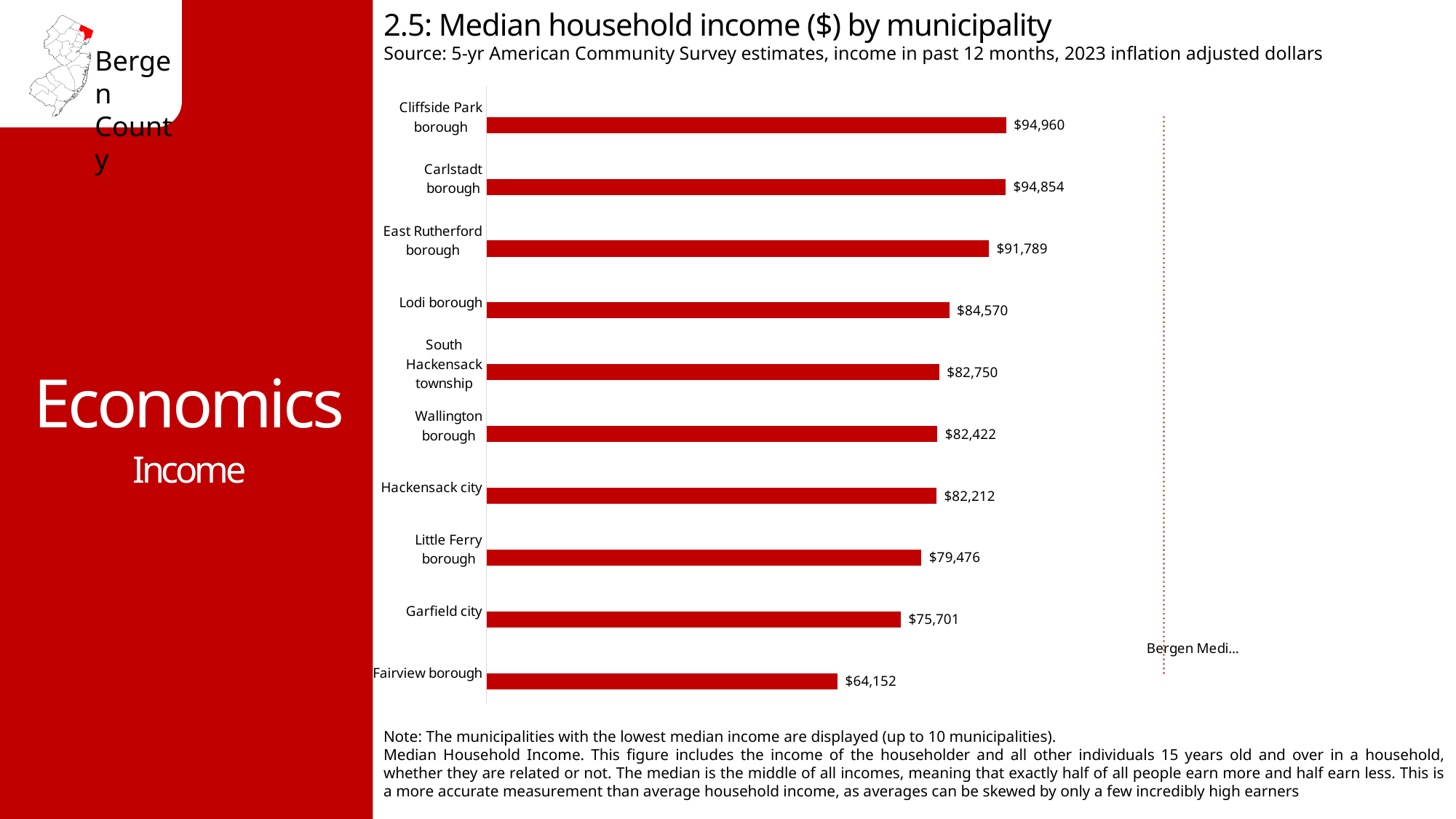
What is the median household income for Fairview borough? $64,152 What is the median household income for Hackensack city? $82,212 Which has a higher median household income, East Rutherford borough or Lodi borough? East Rutherford borough What is the median household income for Lodi borough? $84,570 What is the difference in median household income between Garfield city and Little Ferry borough? $3,775 Which municipality has the highest median household income shown on the chart? Cliffside Park borough What is the difference in median household income between Cliffside Park borough and Fairview borough? $30,808 Which has a higher median household income, Garfield city or Fairview borough? Garfield city What is the title of the chart? 2.5: Median household income ($) by municipality Which municipality has the lowest median household income shown on the chart? Fairview borough How many municipalities are shown on the chart? 10 What kind of chart is shown on the slide? Bar chart